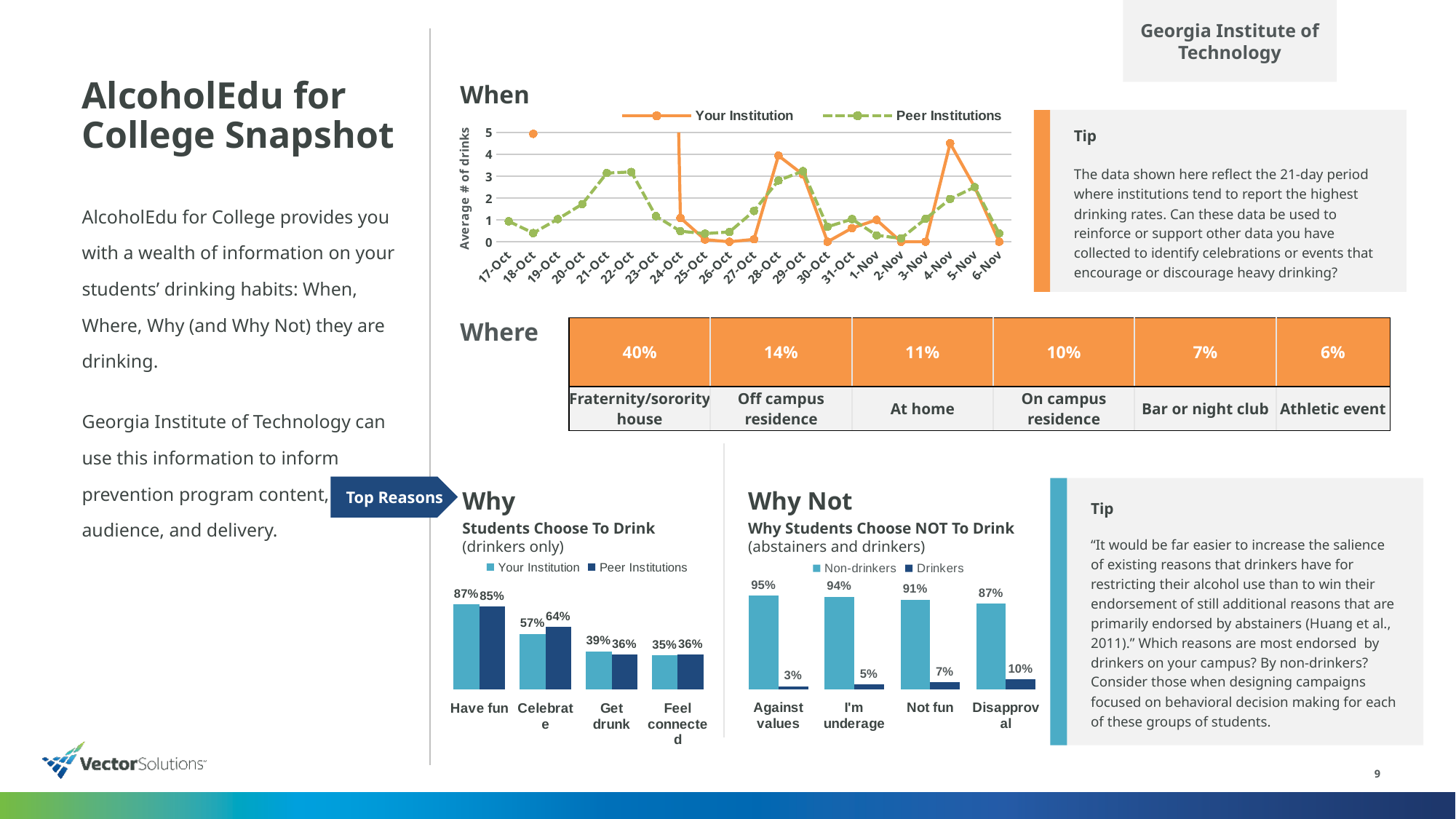
In the "Why" chart (Students Choose To Drink), which is larger for Get drunk: Your Institution or Peer Institutions? Your Institution In the "Why Not" chart (Why Students Choose NOT To Drink), what is the difference between the Non-drinkers and Drinkers values for Not fun? 84 percentage points In the "Why" chart (Students Choose To Drink), what is the Peer Institutions value for Celebrate? 64% In the "Why" chart (Students Choose To Drink), how many reasons are shown on the x axis? 4 In the "Why Not" chart (Why Students Choose NOT To Drink), which reason has the lowest Drinkers value? Against values In the "Why" chart (Students Choose To Drink), which reason has the highest Your Institution value? Have fun In the "Why Not" chart (Why Students Choose NOT To Drink), what is the Drinkers value for Disapproval? 10% In the "Why Not" chart (Why Students Choose NOT To Drink), what is the Non-drinkers value for Against values? 95% In the "When" chart, is the Your Institution value on 4-Nov greater or less than 4? greater What kind of chart is the "When" chart at the top of the slide? Line chart In the "Why" chart (Students Choose To Drink), what is the Your Institution value for Have fun? 87% In the "Why" chart (Students Choose To Drink), how many percentage points higher is the Peer Institutions value than the Your Institution value for Celebrate? 7 percentage points